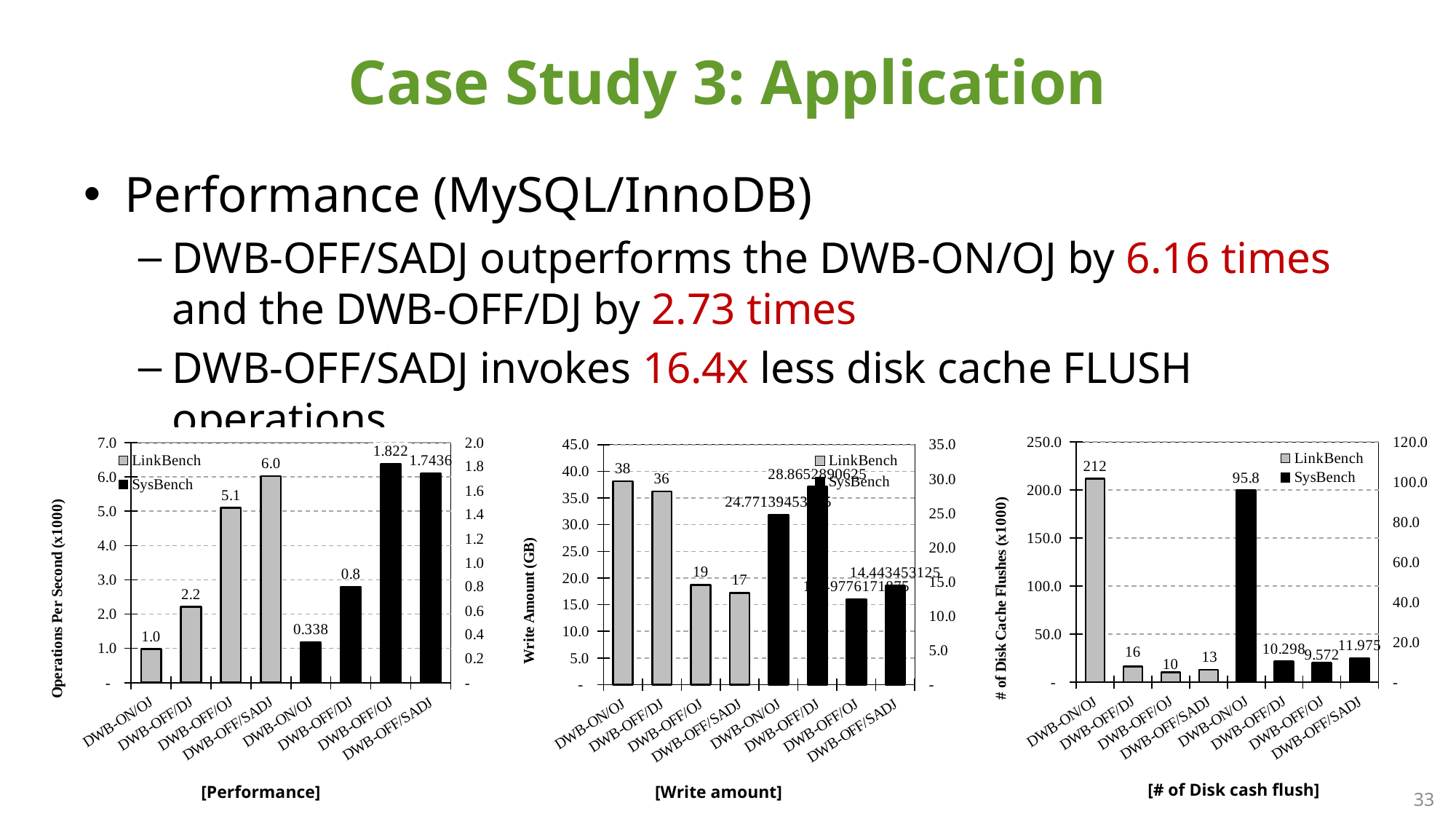
In the [Write amount] chart, which configuration has the lowest LinkBench write amount? DWB-OFF/SADJ In the [Performance] chart, what is the LinkBench value for DWB-OFF/SADJ? 6.0 What kind of chart is the [Write amount] chart? bar chart In the [# of Disk cash flush] chart, which configuration has the highest SysBench value? DWB-ON/OJ In the [Write amount] chart, what is the difference between the LinkBench values for DWB-OFF/DJ and DWB-OFF/OJ? 17 In the [Performance] chart, which configuration has the lowest LinkBench value? DWB-ON/OJ How many series does the legend of the [Performance] chart list? 2 In the [Performance] chart, what is the SysBench value for DWB-ON/OJ? 0.338 In the [Write amount] chart, what is the LinkBench value for DWB-ON/OJ? 38 In the [Performance] chart, what is the difference between the LinkBench values for DWB-OFF/SADJ and DWB-OFF/DJ? 3.8 In the [# of Disk cash flush] chart, what is the SysBench value for DWB-OFF/OJ? 9.572 In the [# of Disk cash flush] chart, what is the LinkBench value for DWB-ON/OJ? 212